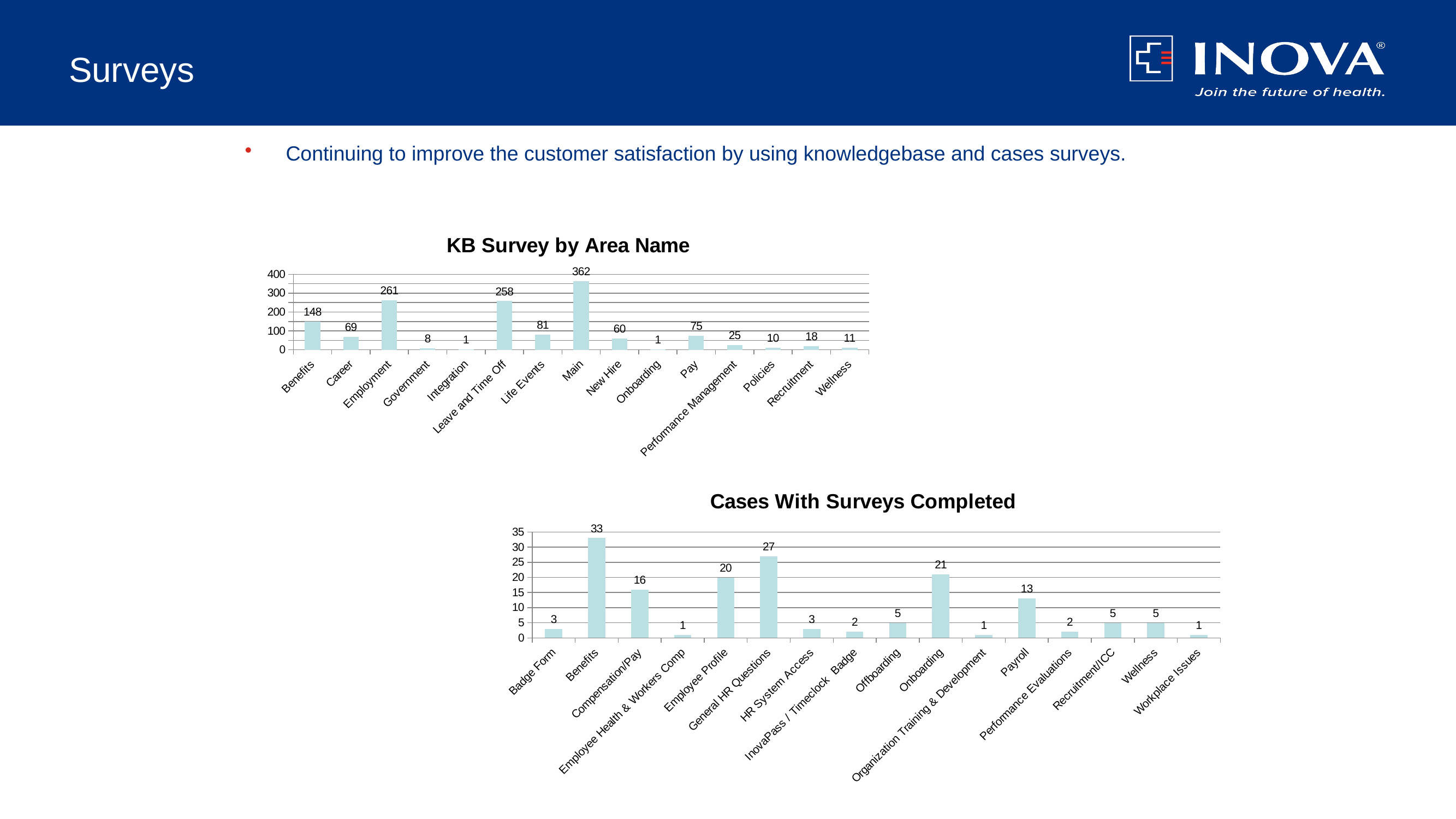
In the 'Cases With Surveys Completed' chart, what is the value for Onboarding? 21 How many categories are shown in the 'Cases With Surveys Completed' chart? 16 In the 'KB Survey by Area Name' chart, what is the difference between Employment and Benefits? 113 What type of chart is 'Cases With Surveys Completed'? Bar chart How many areas are shown in the 'KB Survey by Area Name' chart? 15 In the 'Cases With Surveys Completed' chart, which is larger, Compensation/Pay or Employee Profile? Employee Profile In the 'KB Survey by Area Name' chart, what is the value for Leave and Time Off? 258 In the 'KB Survey by Area Name' chart, which area has the highest value? Main In the 'KB Survey by Area Name' chart, which is larger, Life Events or Pay? Life Events In the 'KB Survey by Area Name' chart, what is the value for Performance Management? 25 In the 'Cases With Surveys Completed' chart, what is the difference between General HR Questions and Payroll? 14 In the 'Cases With Surveys Completed' chart, which category has the highest value? Benefits